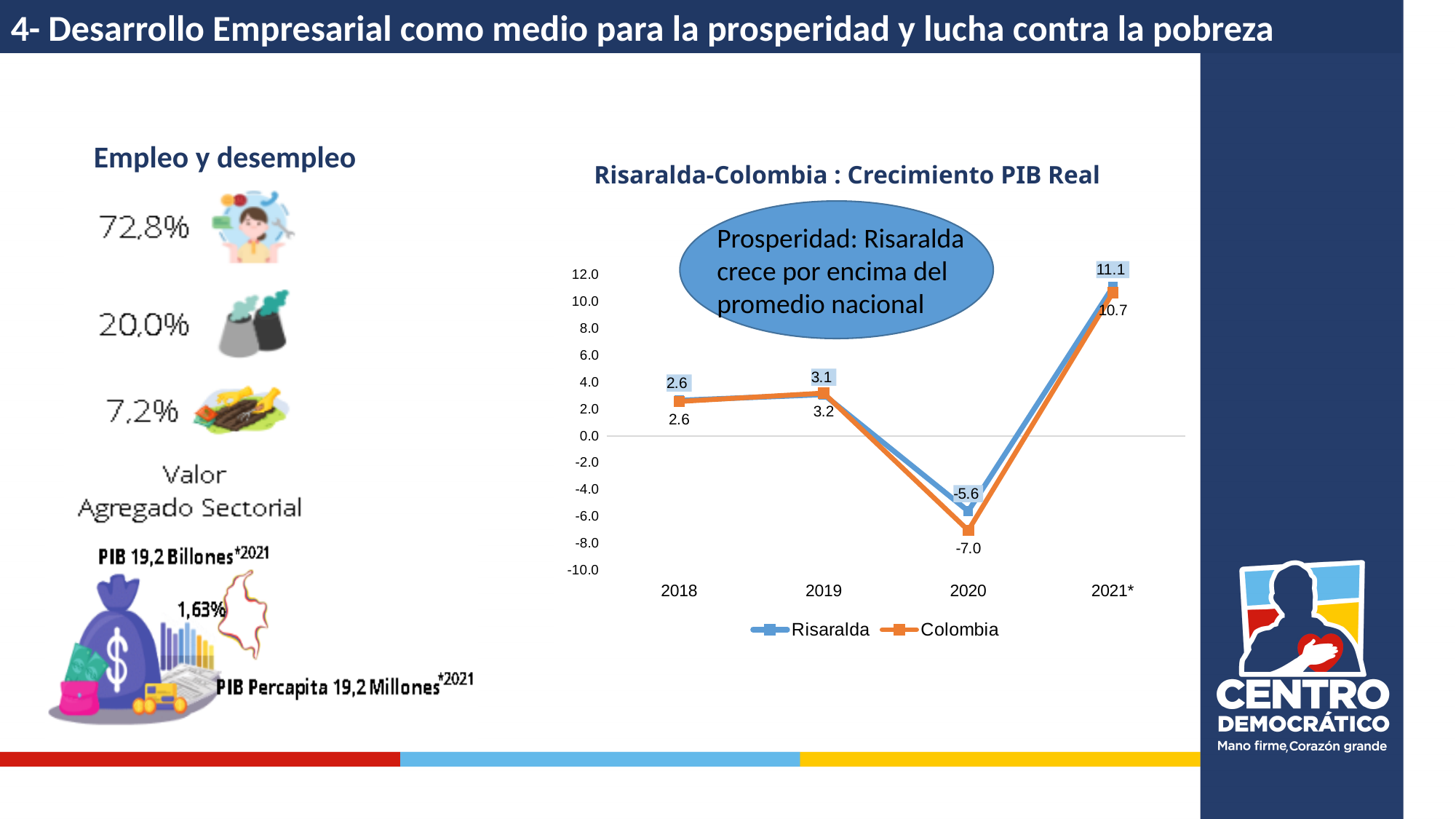
What is the value for Colombia in 2019 in the 'Crecimiento PIB Real' chart? 3.2 Which colour is used for the Colombia series in the 'Crecimiento PIB Real' chart? orange What is the value for Colombia in 2020 in the 'Crecimiento PIB Real' chart? -7.0 What is the difference between the Risaralda and Colombia values in 2021* in the 'Crecimiento PIB Real' chart? 0.4 What is the value for Risaralda in 2020 in the 'Crecimiento PIB Real' chart? -5.6 How many series does the legend of the 'Risaralda-Colombia : Crecimiento PIB Real' chart list? 2 How many years are shown on the x axis of the 'Crecimiento PIB Real' chart? 4 In 2020, which series has the larger value in the 'Crecimiento PIB Real' chart, Risaralda or Colombia? Risaralda What type of chart is shown under the title 'Risaralda-Colombia : Crecimiento PIB Real'? line chart In which year does the Risaralda series reach its highest value in the 'Crecimiento PIB Real' chart? 2021* What is the value for Risaralda in 2021* in the 'Crecimiento PIB Real' chart? 11.1 In which year does the Colombia series reach its lowest value in the 'Crecimiento PIB Real' chart? 2020